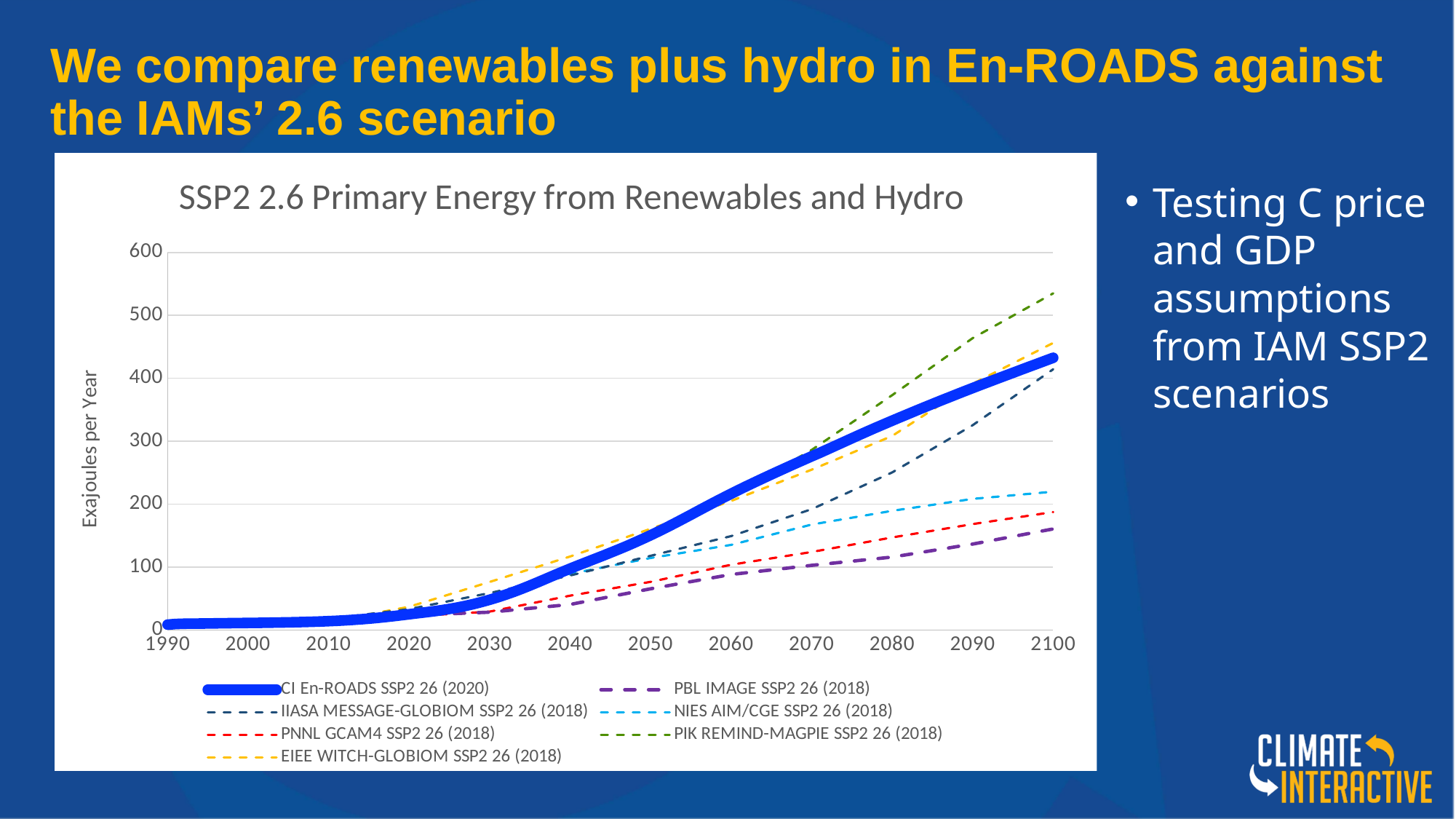
How many series does the legend list? 7 What is the title of the chart? SSP2 2.6 Primary Energy from Renewables and Hydro Which series has the highest value in 2100? PIK REMIND-MAGPIE SSP2 26 (2018) In 2100, which is larger: the value for NIES AIM/CGE SSP2 26 (2018) or the value for PNNL GCAM4 SSP2 26 (2018)? NIES AIM/CGE SSP2 26 (2018) Is the value for PBL IMAGE SSP2 26 (2018) in 2100 greater or less than 200? less Is the value for CI En-ROADS SSP2 26 (2020) in 2060 greater or less than 100? greater Is the value for PIK REMIND-MAGPIE SSP2 26 (2018) in 2100 greater or less than 500? greater Does the CI En-ROADS SSP2 26 (2020) series rise or fall from 1990 to 2100? rise What kind of chart is shown on the slide? line chart Which series has the lowest value in 2100? PBL IMAGE SSP2 26 (2018) What is the label on the vertical axis of the chart? Exajoules per Year